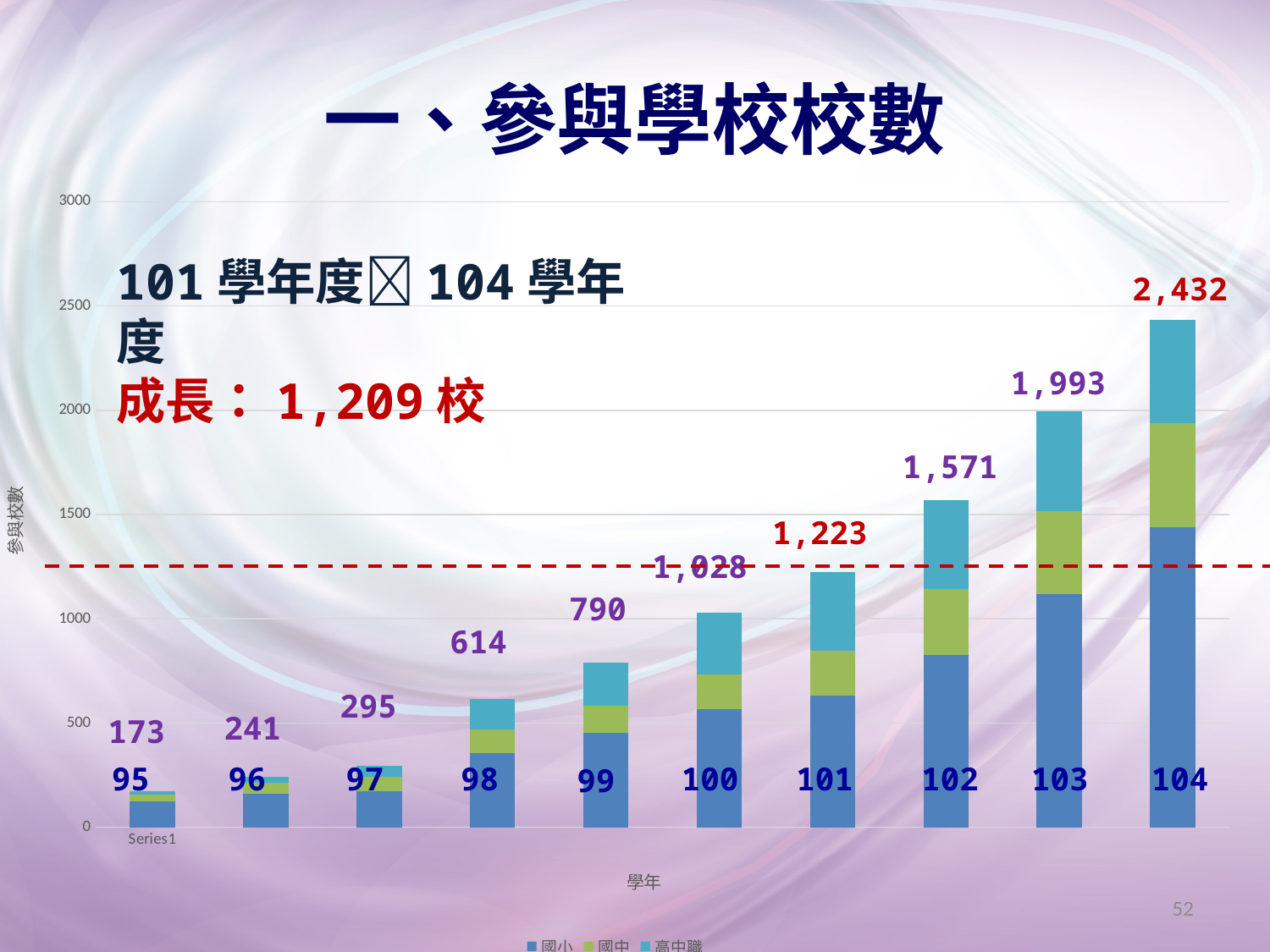
What is the difference between the totals for school years 103 and 102? 422 Which school year has the highest total number of participating schools? 104 What is the total labelled above the bar for school year 98? 614 How many series does the legend list? 3 What is the total labelled above the bar for school year 101? 1,223 What is the total number of participating schools labelled for school year 104? 2,432 How many school years are shown on the x axis? 10 What is the difference between the totals for school years 104 and 101? 1,209 Which has a larger total, school year 99 or school year 100? 100 What kind of chart is shown on the slide? Stacked bar chart Which school year has the lowest total number of participating schools? 95 Do the total values rise or fall from school year 95 to school year 104? Rise